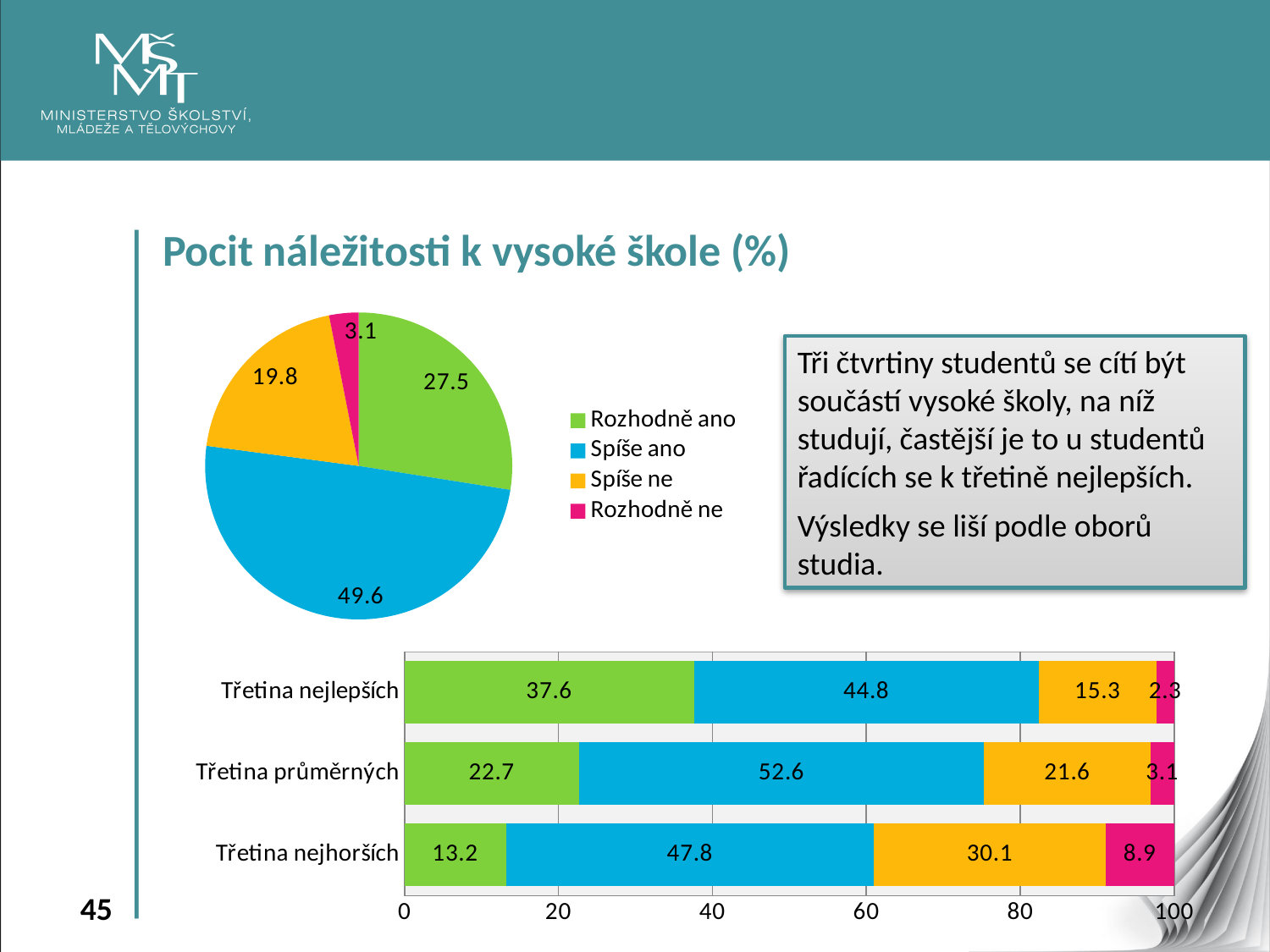
In the pie chart, what is the difference between the values for "Rozhodně ano" and "Spíše ne"? 7.7 How many entries does the legend of the pie chart list? 4 In the pie chart, which category has the smallest slice? Rozhodně ne What type of chart is the bottom chart on the slide? Stacked bar chart In the pie chart, what is the value for "Spíše ano"? 49.6 In the pie chart, which category has the largest slice? Spíše ano In the bottom bar chart, is the orange (Spíše ne) segment larger for "Třetina nejhorších" or for "Třetina průměrných"? Třetina nejhorších In the bottom bar chart, what is the value of the pink (Rozhodně ne) segment for "Třetina nejhorších"? 8.9 In the pie chart, what is the value for "Rozhodně ne"? 3.1 How many categories are shown on the vertical axis of the bottom bar chart? 3 In the bottom bar chart, what is the value of the green (Rozhodně ano) segment for "Třetina nejlepších"? 37.6 In the bottom bar chart, which category has the largest blue (Spíše ano) segment? Třetina průměrných